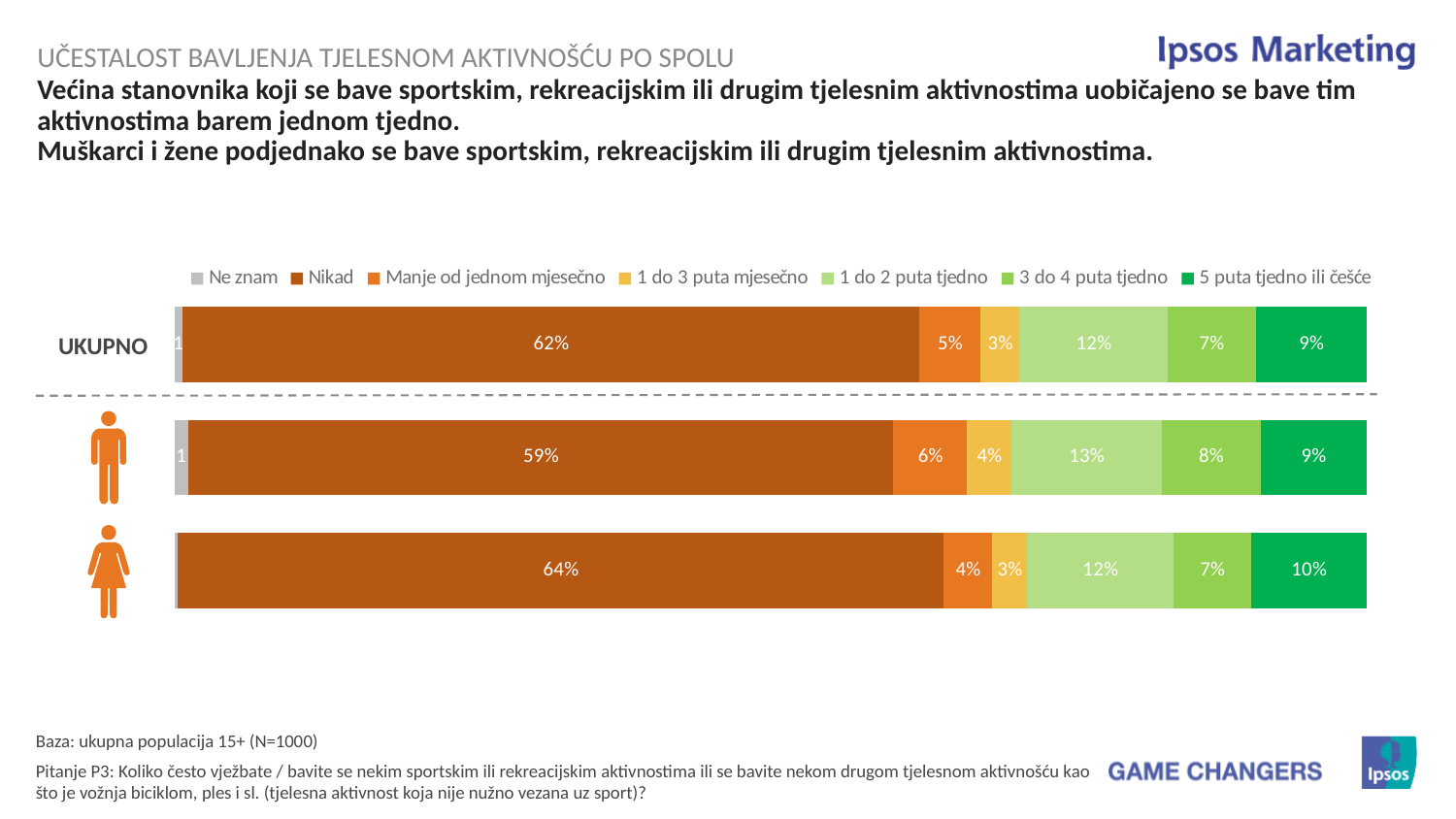
What is the difference in the 3 do 4 puta tjedno value between the row with the male icon and the row with the female icon? 1 percentage point In the row with the male icon, what is the value for 1 do 2 puta tjedno? 13% What is the first entry in the chart legend? Ne znam In the row with the female icon, what is the value for 5 puta tjedno ili češće? 10% In the UKUPNO row, what is the difference between 1 do 2 puta tjedno and 3 do 4 puta tjedno? 5 percentage points How many bars (rows) are plotted in the chart? 3 What kind of chart is shown on the slide? Stacked bar chart Which row has the larger Nikad value, the one with the male icon or the one with the female icon? The row with the female icon Which category has the largest share in the UKUPNO bar? Nikad In the row with the male icon, what is the value for Manje od jednom mjesečno? 6% How many series does the legend list? 7 What percentage of the UKUPNO row falls in the Nikad category? 62%